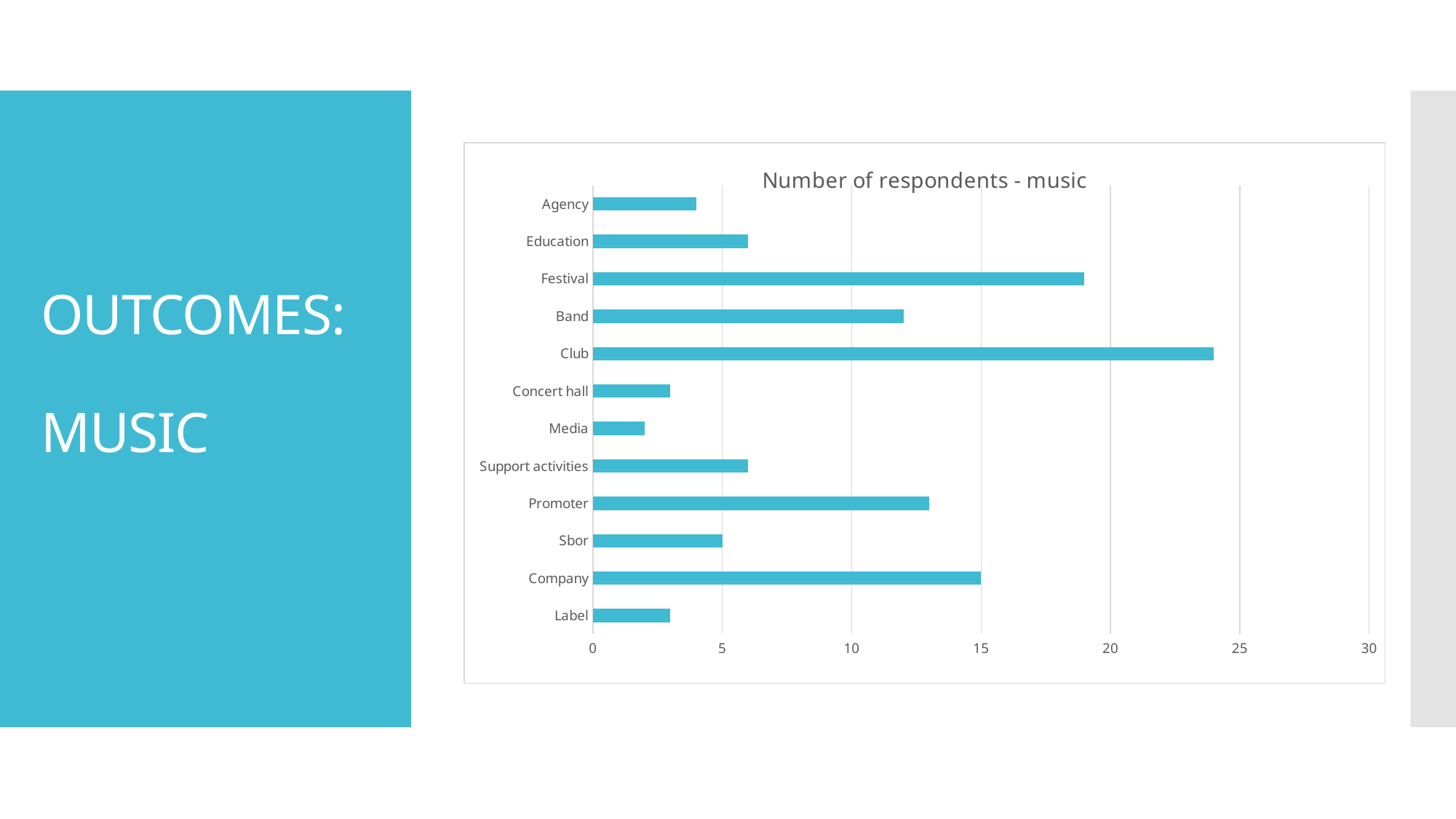
How many categories are shown in the chart? 12 Is the value for Agency greater or less than 5? less What is the number of respondents for Company? 15 What is the number of respondents for Sbor? 5 Which has more respondents, Festival or Company? Festival Which category has the highest number of respondents? Club Which category has the lowest number of respondents? Media Which has more respondents, Band or Promoter? Promoter Is the value for Club greater or less than 20? greater What type of chart is shown on the slide? bar chart Is the value for Festival greater or less than 15? greater What is the title of the chart? Number of respondents - music